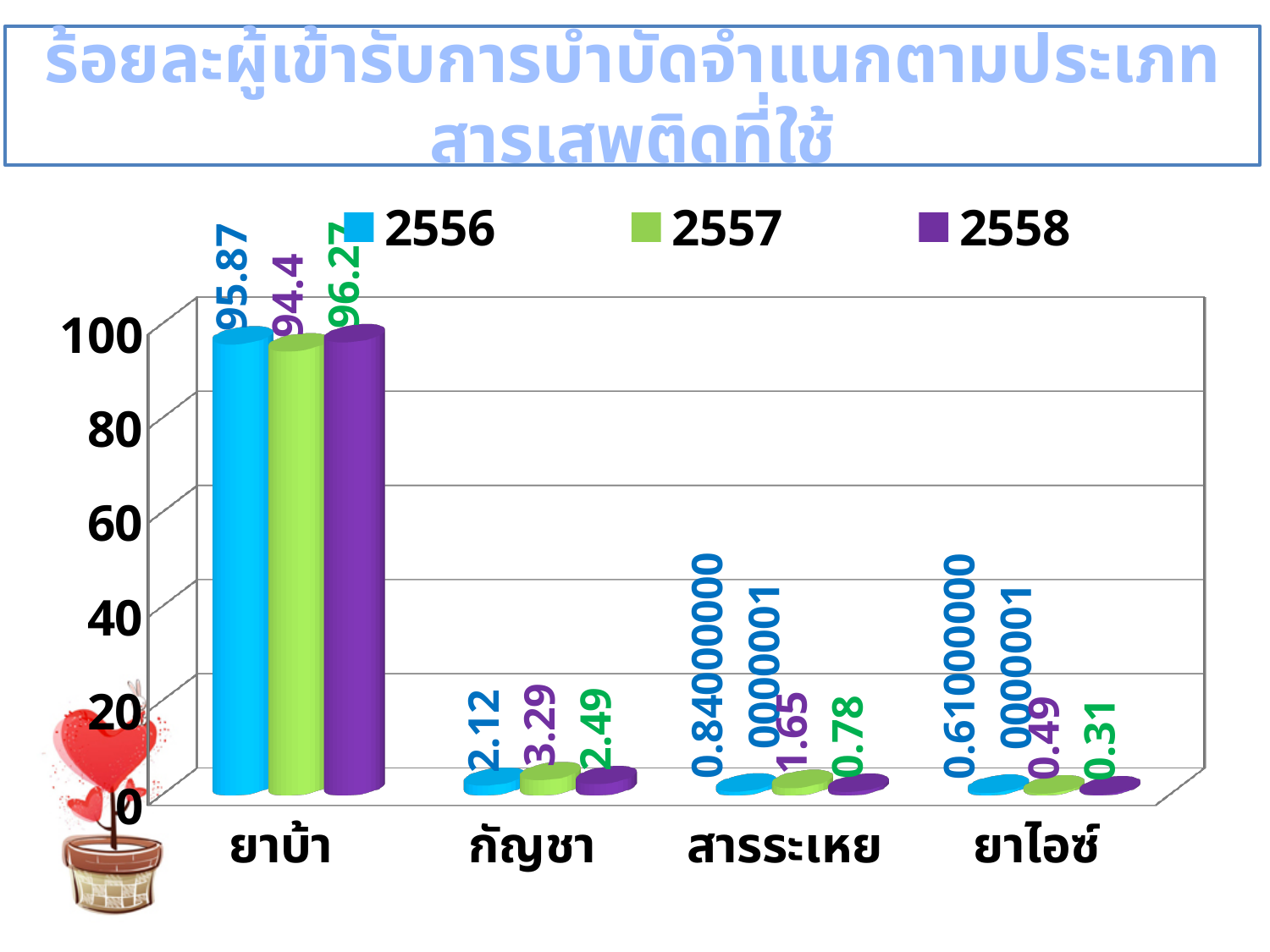
Which category has the lowest value in the 2558 series? ยาไอซ์ What is the value for ยาบ้า in the 2556 series? 95.87 What is the value for ยาไอซ์ in the 2558 series? 0.31 How many categories are shown on the x axis? 4 How many series does the legend list? 3 What is the difference between the 2557 and 2556 values for กัญชา? 1.17 Which category has the highest values across all series? ยาบ้า For กัญชา, which series has the larger value, 2557 or 2558? 2557 What is the value for สารระเหย in the 2558 series? 0.78 What is the value for กัญชา in the 2557 series? 3.29 What is the difference between the 2558 and 2557 values for ยาบ้า? 1.87 Is the value for ยาบ้า in 2557 greater or less than 80? greater